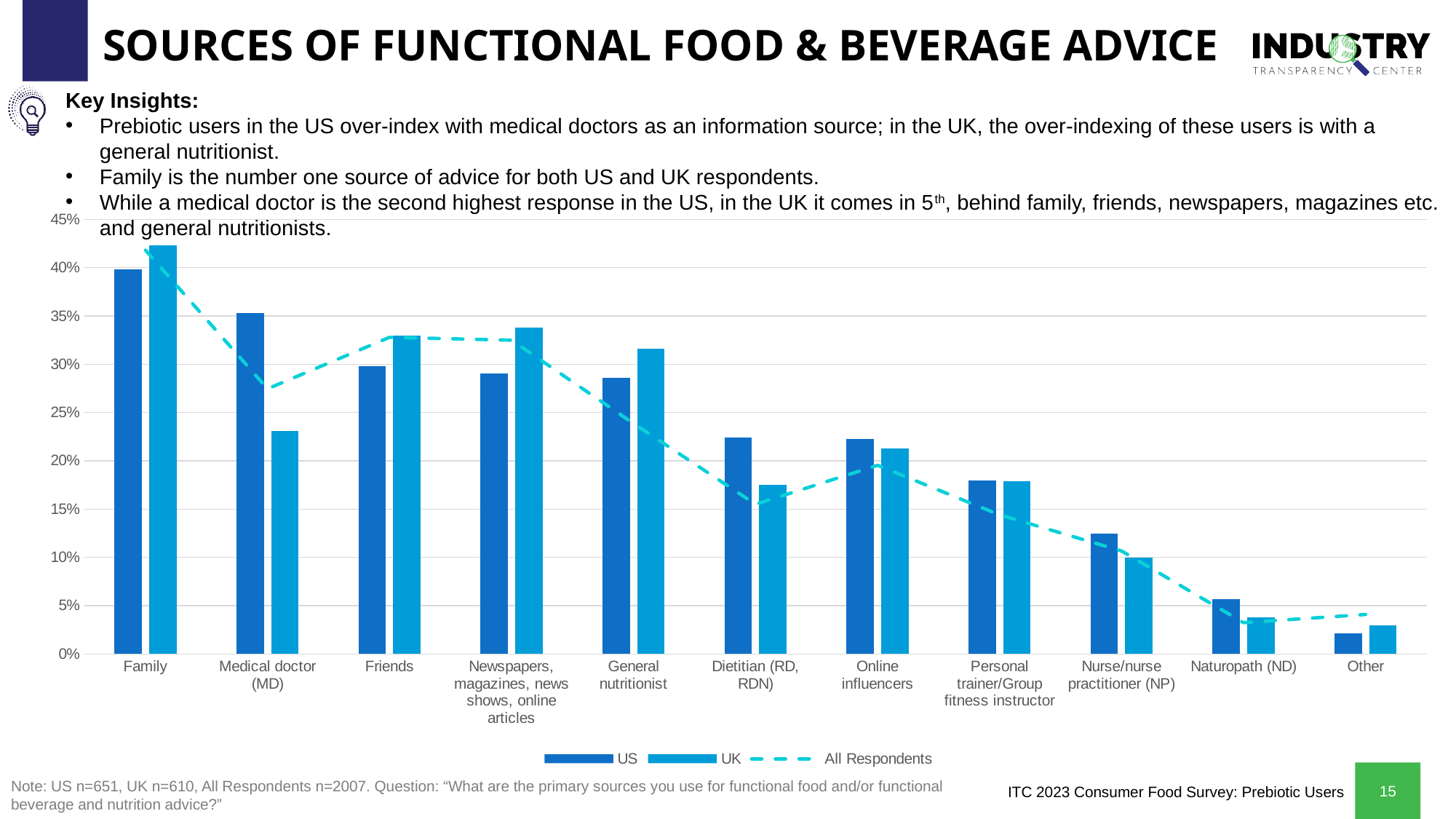
For Friends, which is larger, the US value or the UK value? UK Which category has the highest US value? Family What kind of chart is shown on the slide? bar and line chart How many advice-source categories are shown on the x axis? 11 Which category has the highest UK value? Family Is the UK value for Medical doctor (MD) greater or less than 25%? less Which category has the lowest US value? Other How many series does the legend list? 3 Which series is drawn as a dashed line? All Respondents Is the US value for Medical doctor (MD) greater or less than 30%? greater Is the UK value for Nurse/nurse practitioner (NP) greater or less than 15%? less For Medical doctor (MD), which is larger, the US value or the UK value? US